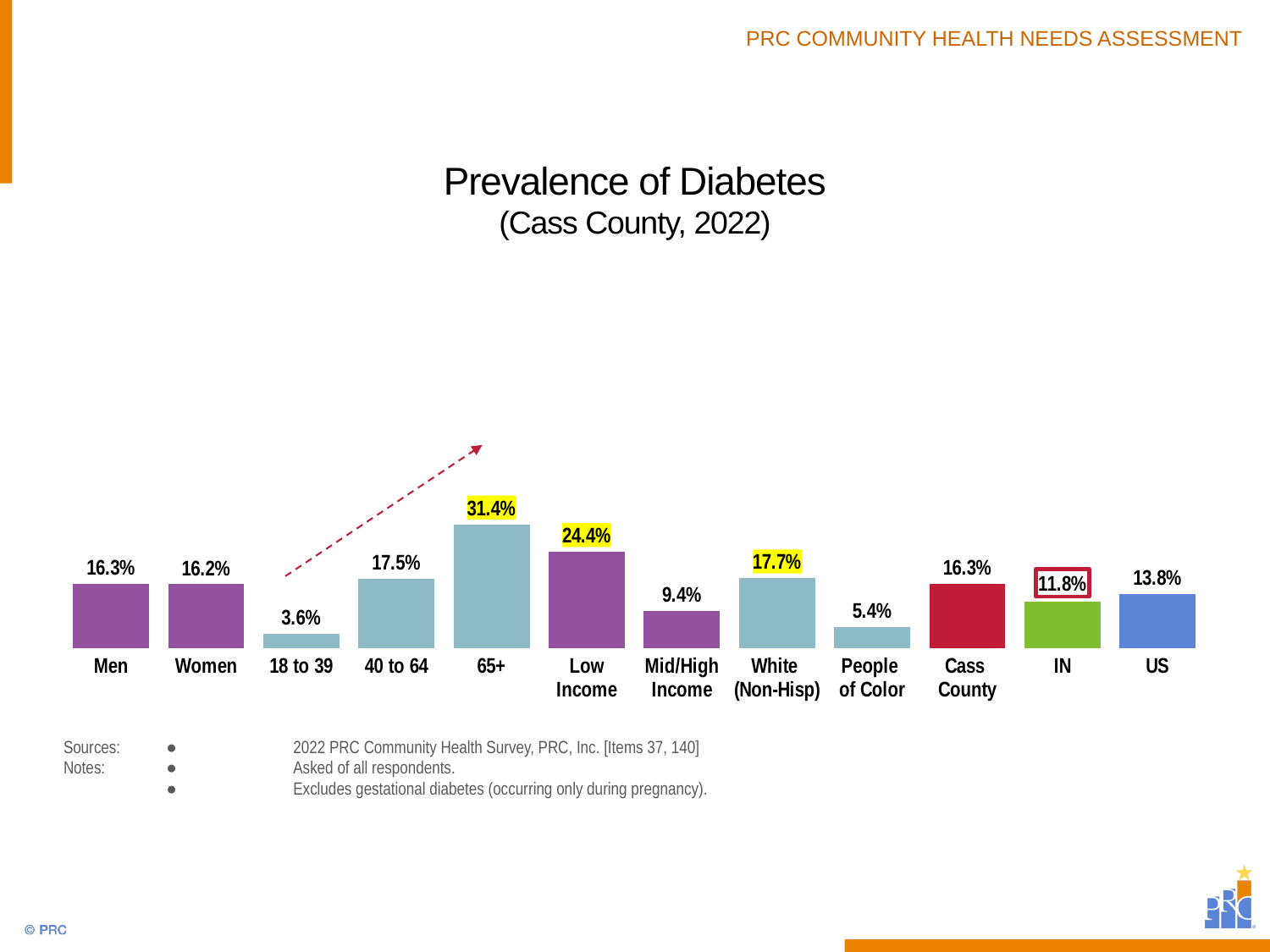
Which is larger, the value for White (Non-Hisp) or the value for People of Color? White (Non-Hisp) How many categories are shown in the chart? 12 What is the title of the chart? Prevalence of Diabetes (Cass County, 2022) What is the prevalence of diabetes for the 65+ age group? 31.4% Do the values rise or fall across the age groups from 18 to 39 to 65+? Rise What is the value shown for IN? 11.8% What is the value shown for Low Income? 24.4% Which category has the lowest prevalence of diabetes? 18 to 39 What kind of chart is shown on the slide? Bar chart What is the difference between the Low Income and Mid/High Income values? 15.0% What is the difference between the Cass County and US values? 2.5% Which category has the highest prevalence of diabetes? 65+